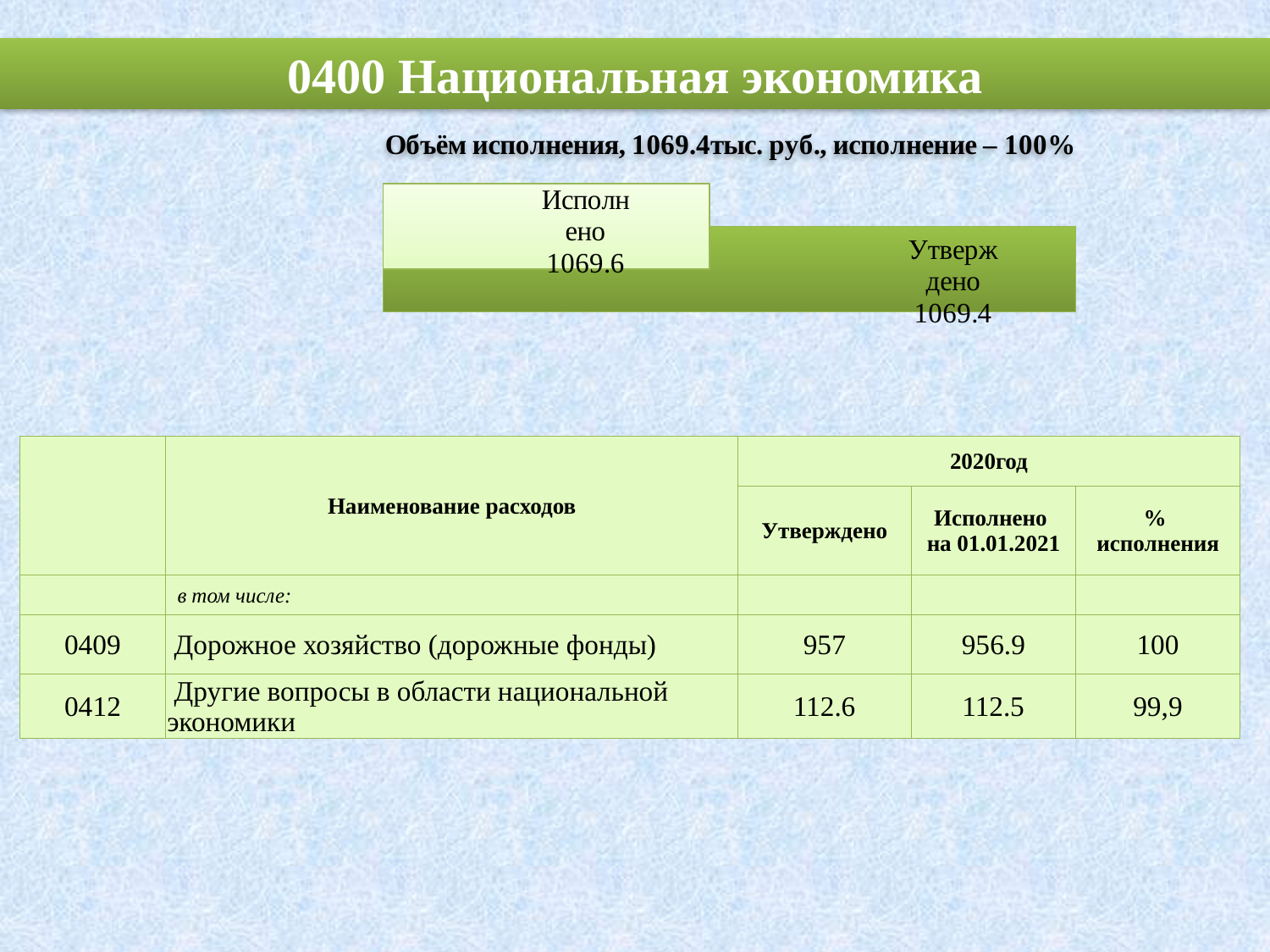
What is the difference between the Исполнено value and the Утверждено value on the chart? 0.2 How many bars does the chart show? 2 What kind of chart is shown on the slide? bar chart What colour is the Утверждено bar on the chart? dark green What value is shown for Исполнено on the bar chart? 1069.6 What value is shown for Утверждено on the bar chart? 1069.4 What colour is the Исполнено bar on the chart? light green